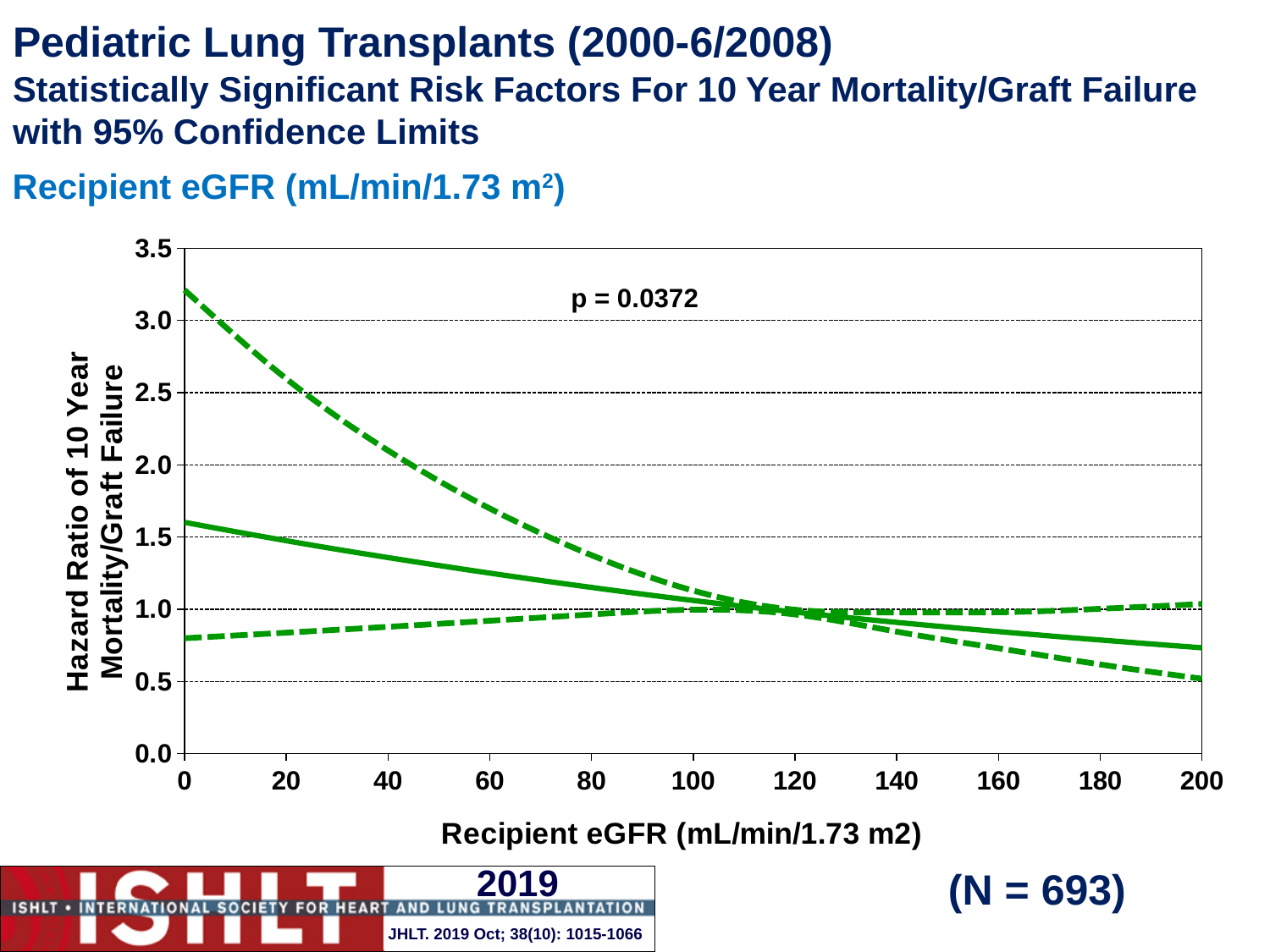
Is the upper dashed confidence limit at a recipient eGFR of 60 greater or less than 2.0? less Is the upper dashed confidence limit at a recipient eGFR of 0 greater or less than 3.0? greater How many lines are plotted on the chart? 3 Is the lower dashed confidence limit at a recipient eGFR of 0 greater or less than 1.0? less What is the sample size (N) shown on the slide? N = 693 What kind of chart is shown on the slide? line chart Does the solid hazard ratio line rise or fall as recipient eGFR increases from 0 to 200? fall What p-value is printed on the chart? p = 0.0372 Is the hazard ratio on the solid line higher at a recipient eGFR of 0 or at a recipient eGFR of 200? 0